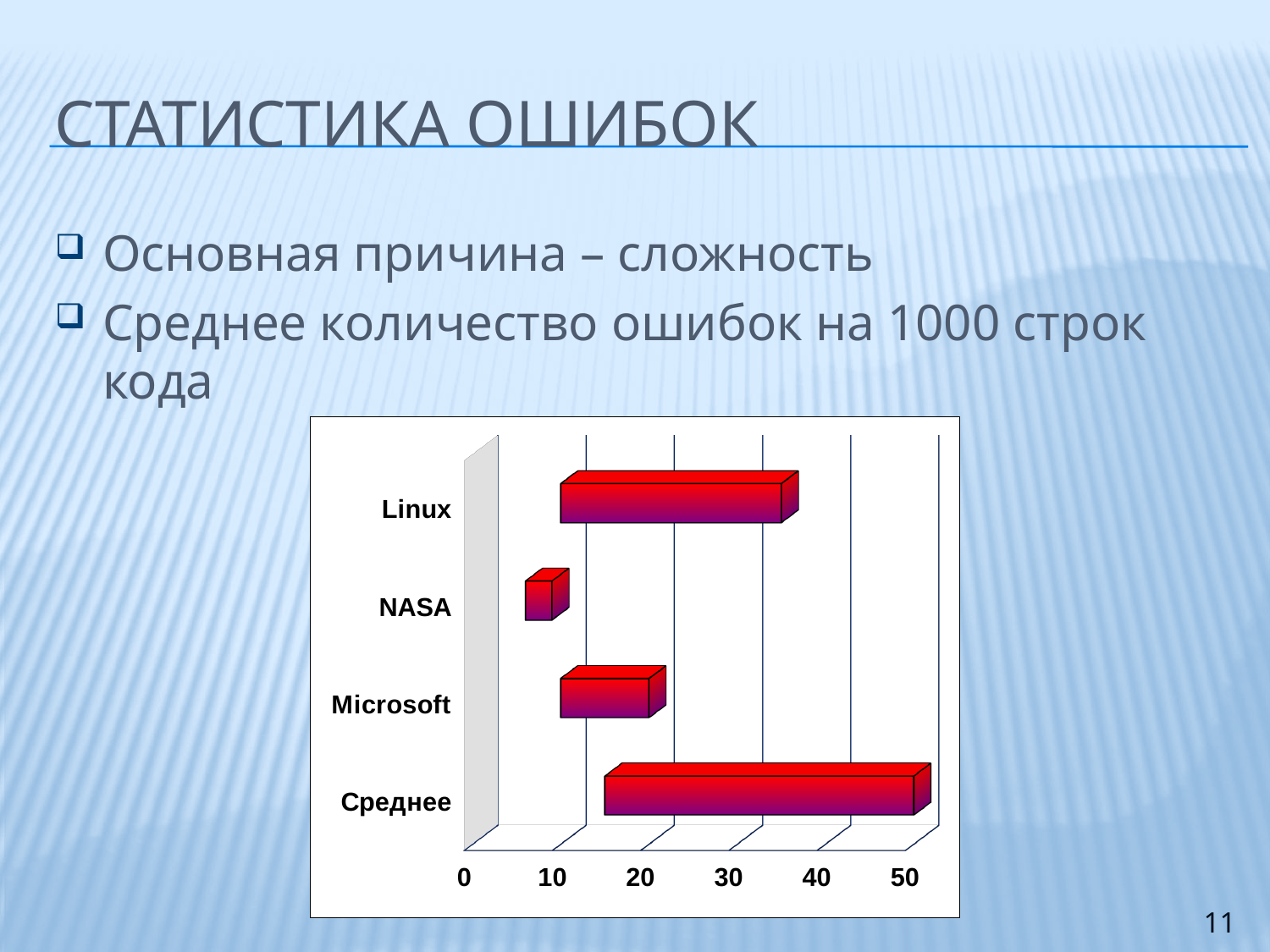
What colour are the bars in the chart? red What kind of chart is shown on the slide? bar chart Is the value for Linux greater or less than 40? less How many categories are plotted in the chart? 4 Is the value for Linux greater or less than 30? greater Which has a larger value, NASA or Microsoft? Microsoft Which category has the highest value in the chart? Среднее Is the value for Среднее greater or less than 40? greater Which has a larger value, Linux or Microsoft? Linux Which category has the lowest value in the chart? NASA